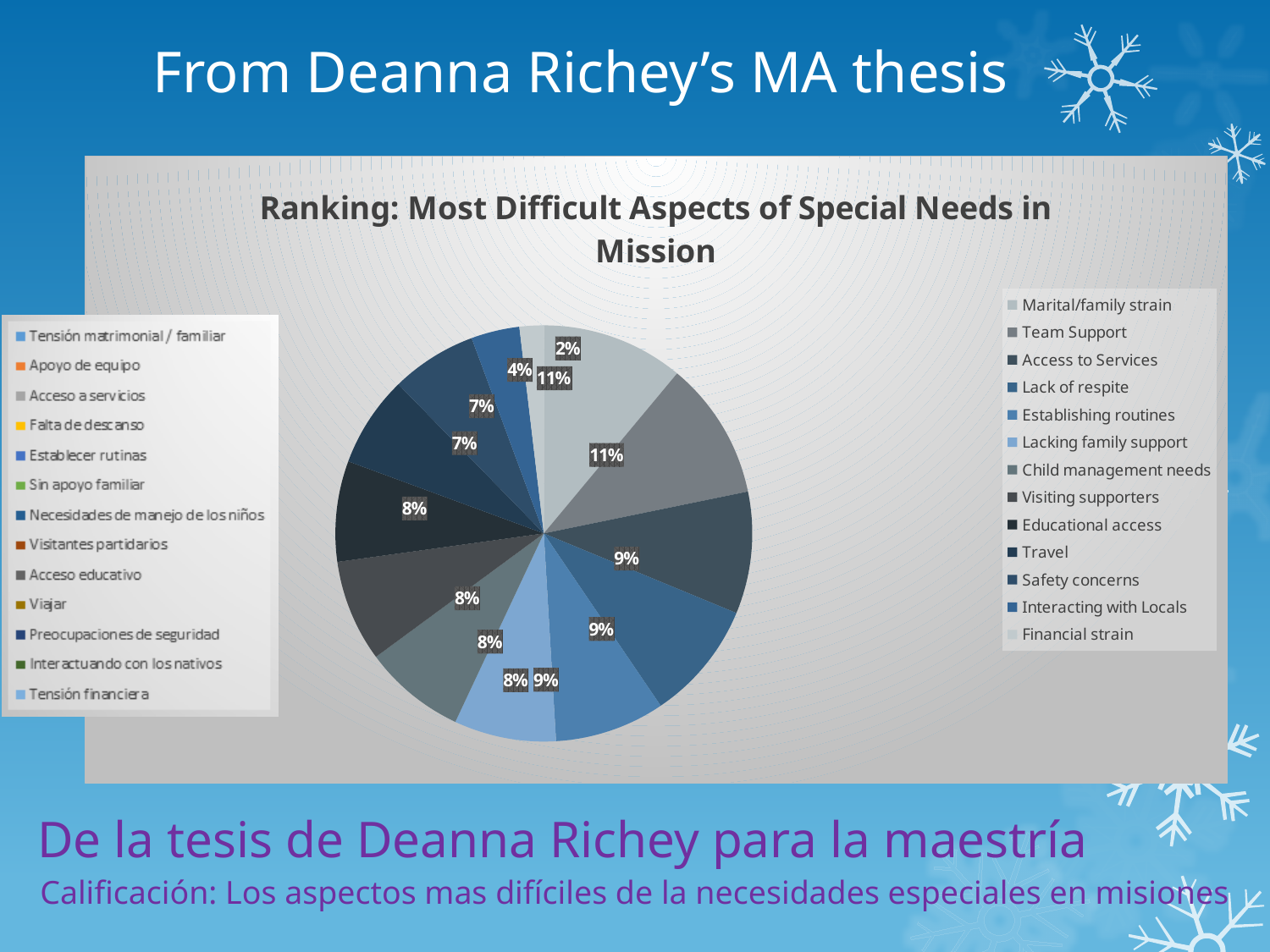
Which legend entry is listed first in the English legend of the chart? Marital/family strain What is the difference in percentage points between the largest slice (11%) and the smallest slice (2%)? 9 percentage points How many slices of the pie chart are labelled 11%? 2 What kind of chart is shown on the slide? pie chart Which is larger, the slice for Financial strain or the slice for Interacting with Locals? Interacting with Locals What share of the pie does Financial strain represent? 2% What share of the pie does Marital/family strain represent? 11% How many categories does the English legend of the pie chart list? 13 What share of the pie does Interacting with Locals represent? 4% What is the largest percentage shown on any slice of the pie chart? 11% What is the title of the chart? Ranking: Most Difficult Aspects of Special Needs in Mission What is the smallest percentage shown on any slice of the pie chart? 2%